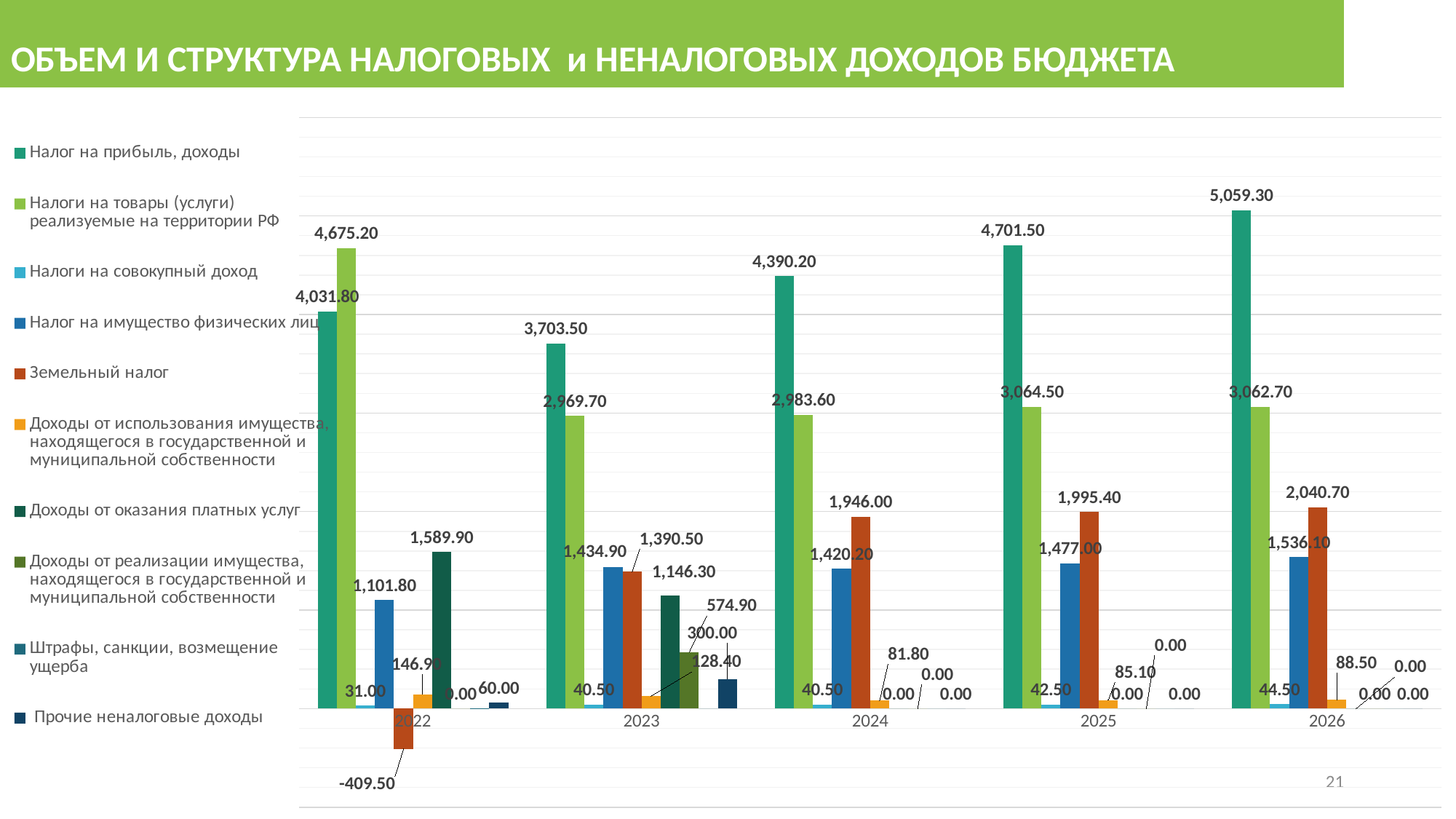
What is the value of Налоги на совокупный доход for 2025? 42.50 What is the value of Земельный налог for 2022? -409.50 What kind of chart is shown on the slide? Bar chart In which year is Налог на прибыль, доходы the lowest? 2023 What is the value of Налог на прибыль, доходы for 2026? 5,059.30 In which year is Налог на прибыль, доходы the highest? 2026 What is the value of Налог на имущество физических лиц for 2024? 1,420.20 Does Земельный налог rise or fall from 2023 to 2026? Rises By how much does Налог на прибыль, доходы in 2026 exceed its value in 2025? 357.80 In 2022, which is larger: Налог на прибыль, доходы or Налоги на товары (услуги) реализуемые на территории РФ? Налоги на товары (услуги) реализуемые на территории РФ How many series does the legend list? 10 How many years are shown on the x axis? 5